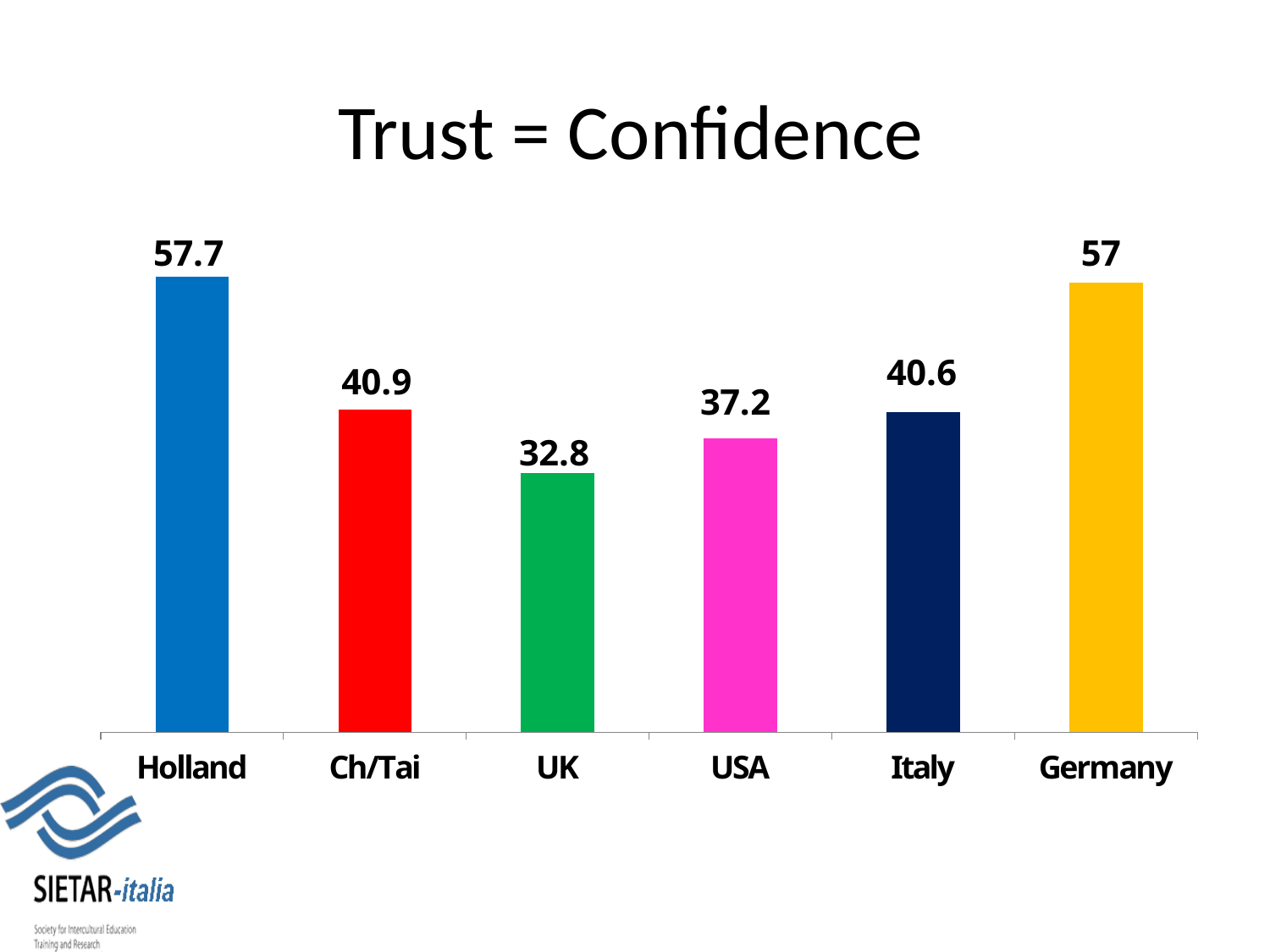
What is the value for Italy? 40.6 What is the value for Germany? 57 Which category has the lowest value? UK Which category has the highest value? Holland What is the value for Holland? 57.7 Which is larger, the value for USA or the value for Italy? Italy How many categories are shown in the chart? 6 What kind of chart is shown on the slide? Bar chart What is the difference between the values for Holland and UK? 24.9 What is the title of the slide? Trust = Confidence What is the value for UK? 32.8 What is the difference between the values for Ch/Tai and USA? 3.7